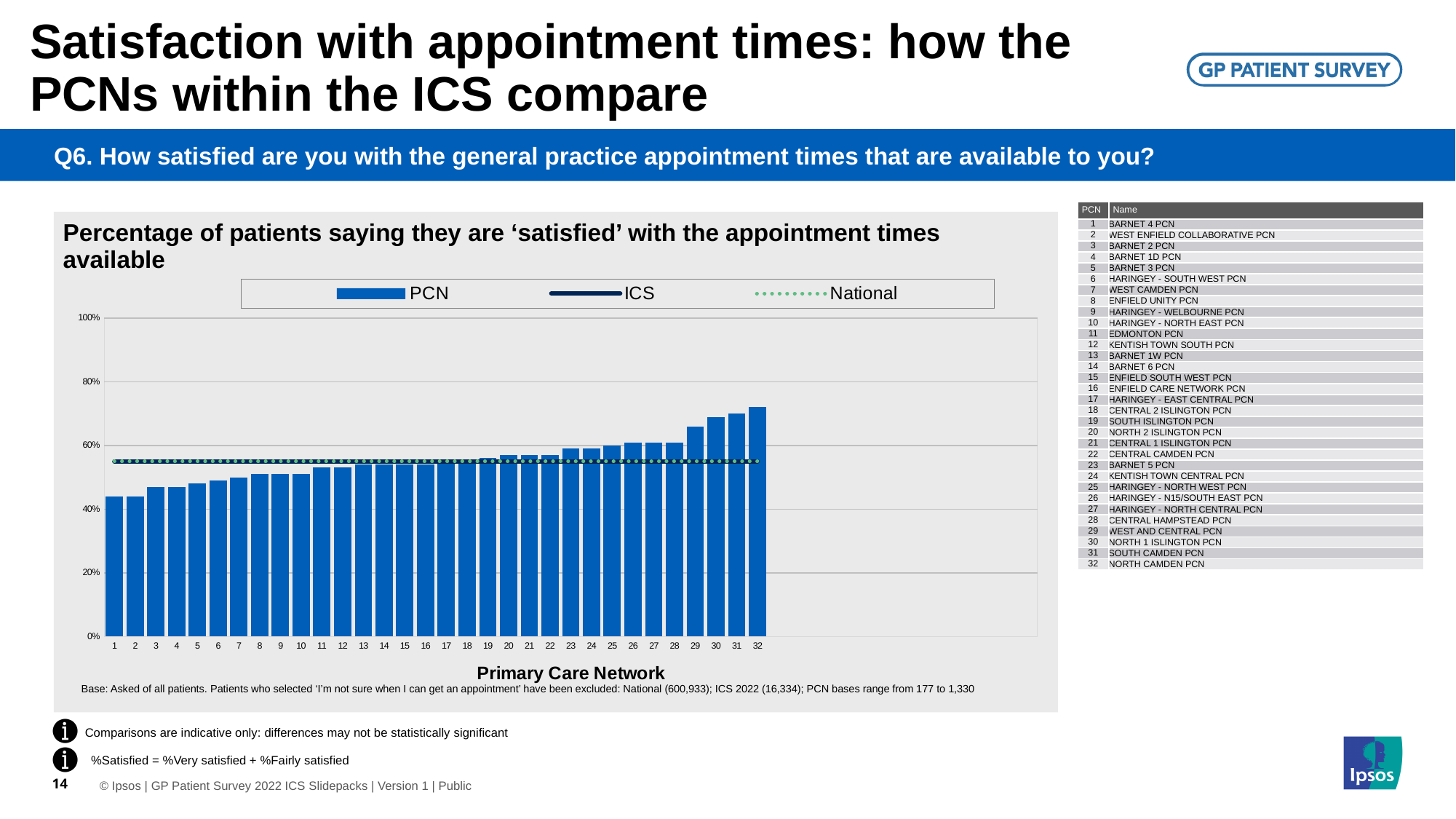
Is the value for PCN 32 greater or less than 60%? greater Is the value for PCN 10 greater or less than 40%? greater How many series does the chart legend list? 3 What is the title of the x axis of the chart? Primary Care Network What kind of chart is used to show the percentage of patients satisfied with appointment times? Bar chart Which has the larger value, PCN 32 or PCN 1? PCN 32 Do the bar values rise or fall moving from PCN 1 to PCN 32 along the x axis? Rise Is the value for PCN 29 greater or less than 60%? greater Which has the larger value, PCN 10 or PCN 29? PCN 29 How many Primary Care Networks (bars) are plotted on the chart? 32 Which PCN has the highest percentage of patients satisfied with appointment times? 32